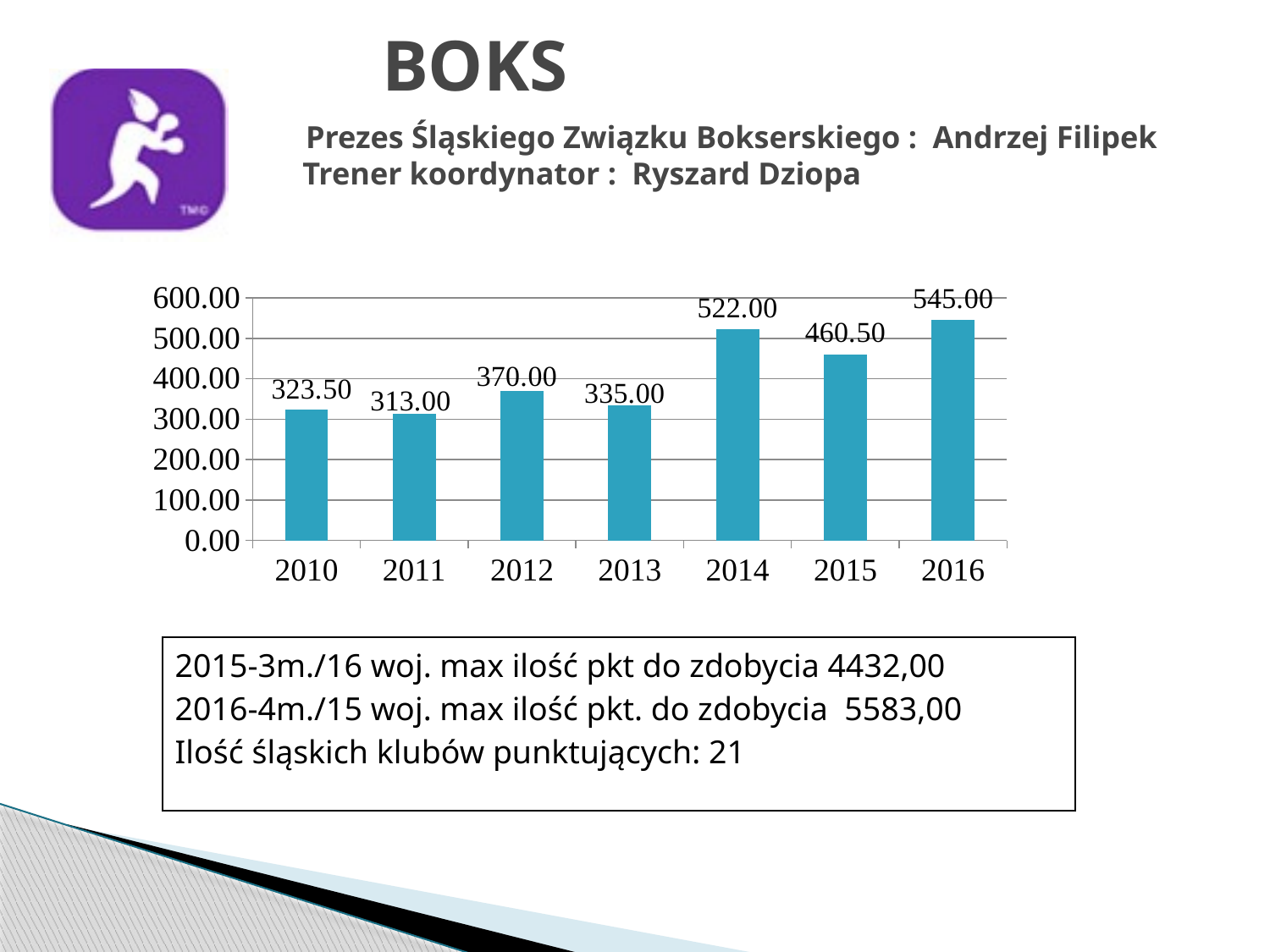
What kind of chart is shown on the slide? bar chart What is the value for 2014? 522.00 Is the value for 2014 greater or less than 500.00? greater What is the difference between the values for 2014 and 2013? 187.00 Which year has the highest value? 2016 What is the value for 2015? 460.50 Does the value rise or fall from 2013 to 2014? rise What is the value for 2010? 323.50 How many years are shown on the x axis? 7 Which is larger, the value for 2012 or the value for 2013? 2012 What is the difference between the values for 2016 and 2015? 84.50 Which year has the lowest value? 2011